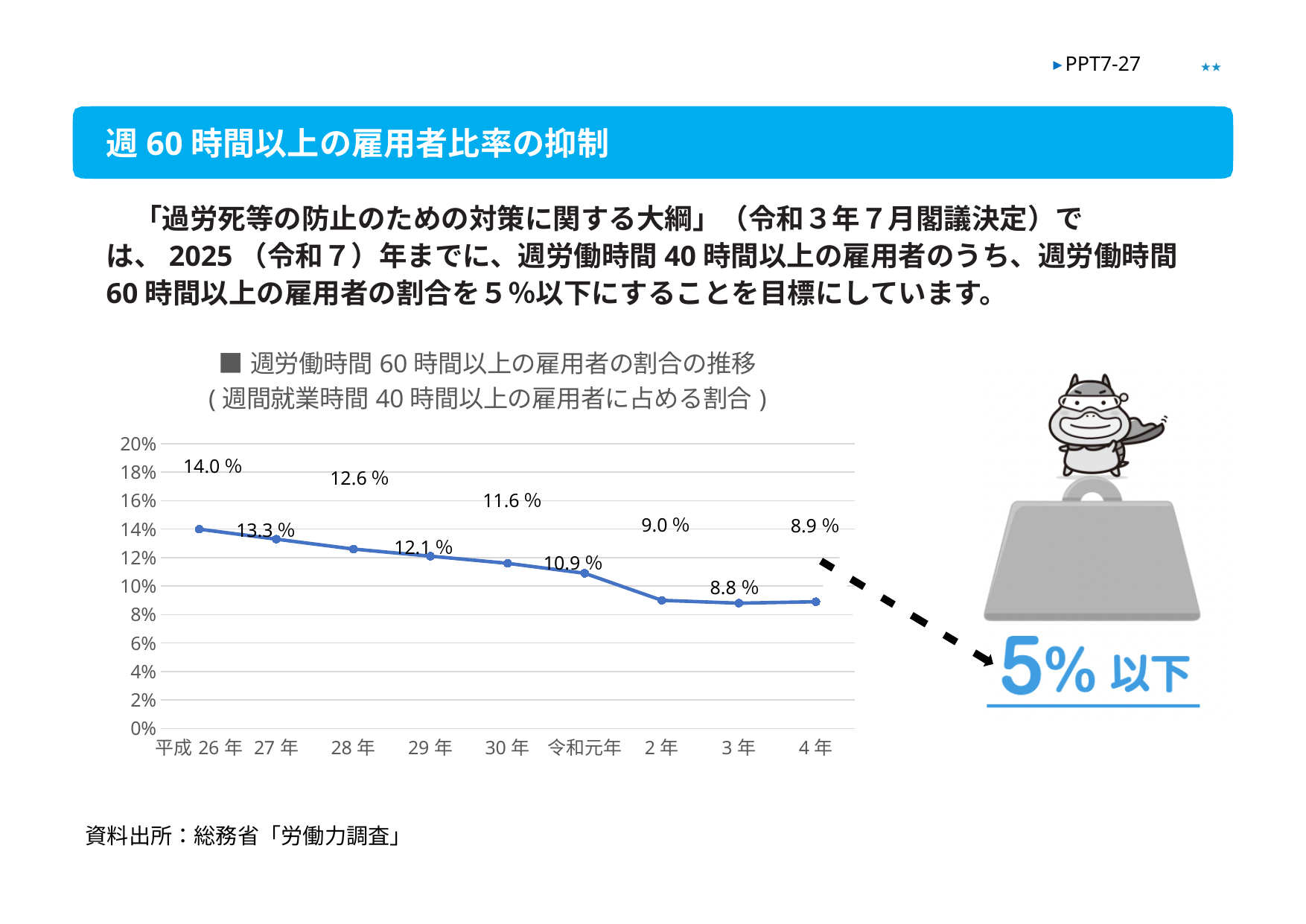
Which is larger, the value for 平成28年 or the value for 令和2年? 平成28年 Which year has the lowest value in the line chart? 令和3年 What is the value for 令和元年 in the line chart? 10.9% Is the value for 平成30年 greater or less than 10%? greater What is the value for 平成26年 in the line chart? 14.0% What is the difference between the values for 平成26年 and 令和4年? 5.1 percentage points What kind of chart is shown on the slide? line chart What is the value for 令和4年 in the line chart? 8.9% How many data points are plotted in the line chart? 9 What is the target value shown to the right of the chart? 5%以下 Which year has the highest value in the line chart? 平成26年 Do the values generally rise or fall from 平成26年 to 令和4年? fall